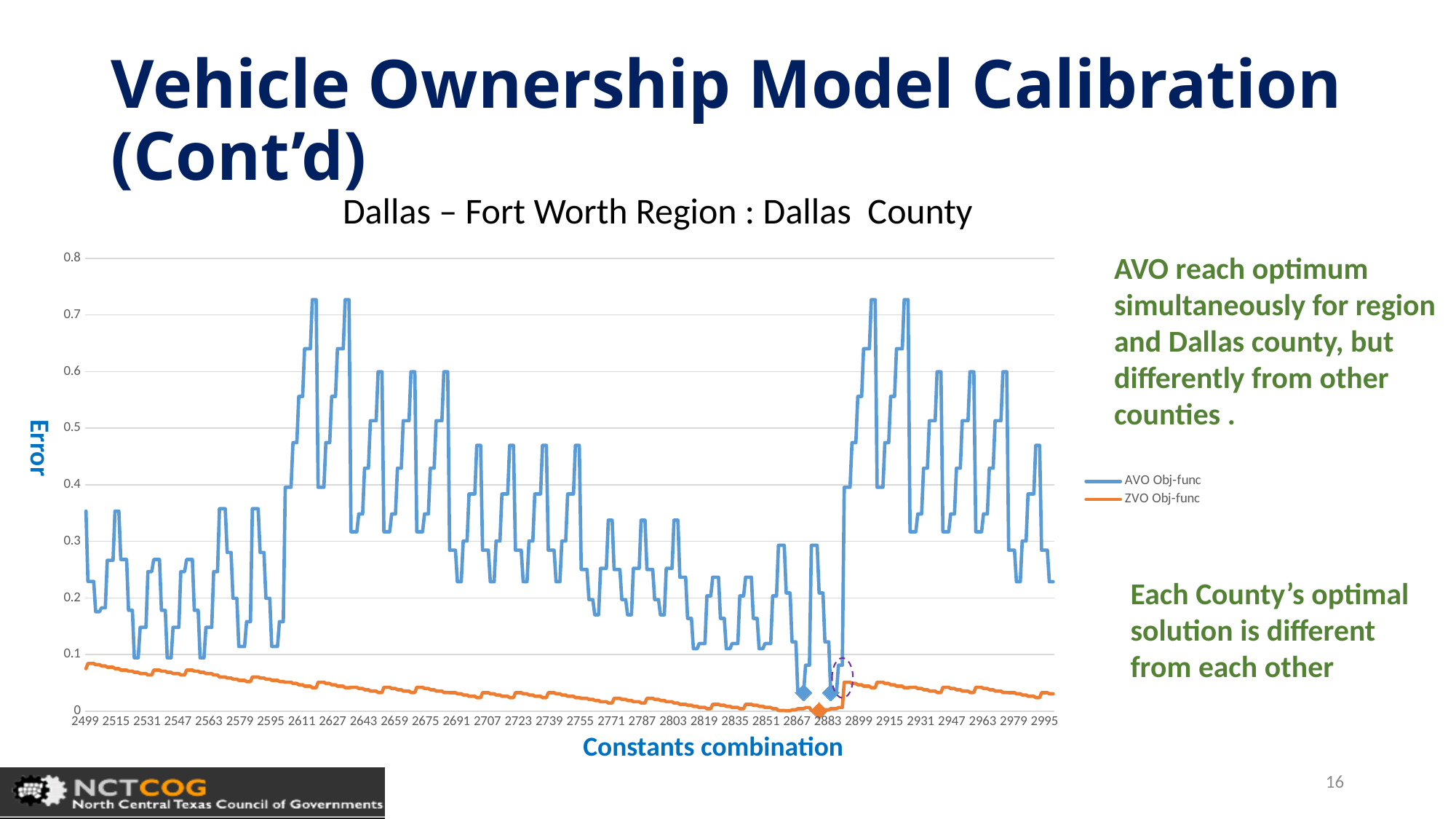
Is the highest peak of the AVO Obj-func series greater or less than 0.6? greater Is the AVO Obj-func value at constants combination 2995 greater or less than 0.4? less What is the title of the chart? Dallas – Fort Worth Region : Dallas County Which series reaches the highest error value on the chart? AVO Obj-func Does the ZVO Obj-func series generally rise or fall from constants combination 2499 to around 2867? fall What kind of chart is shown on the slide? line chart At constants combination 2499, which series has the higher error, AVO Obj-func or ZVO Obj-func? AVO Obj-func Is the ZVO Obj-func value at constants combination 2499 greater or less than 0.2? less What are the two series named in the chart legend? AVO Obj-func and ZVO Obj-func How many series does the chart legend list? 2